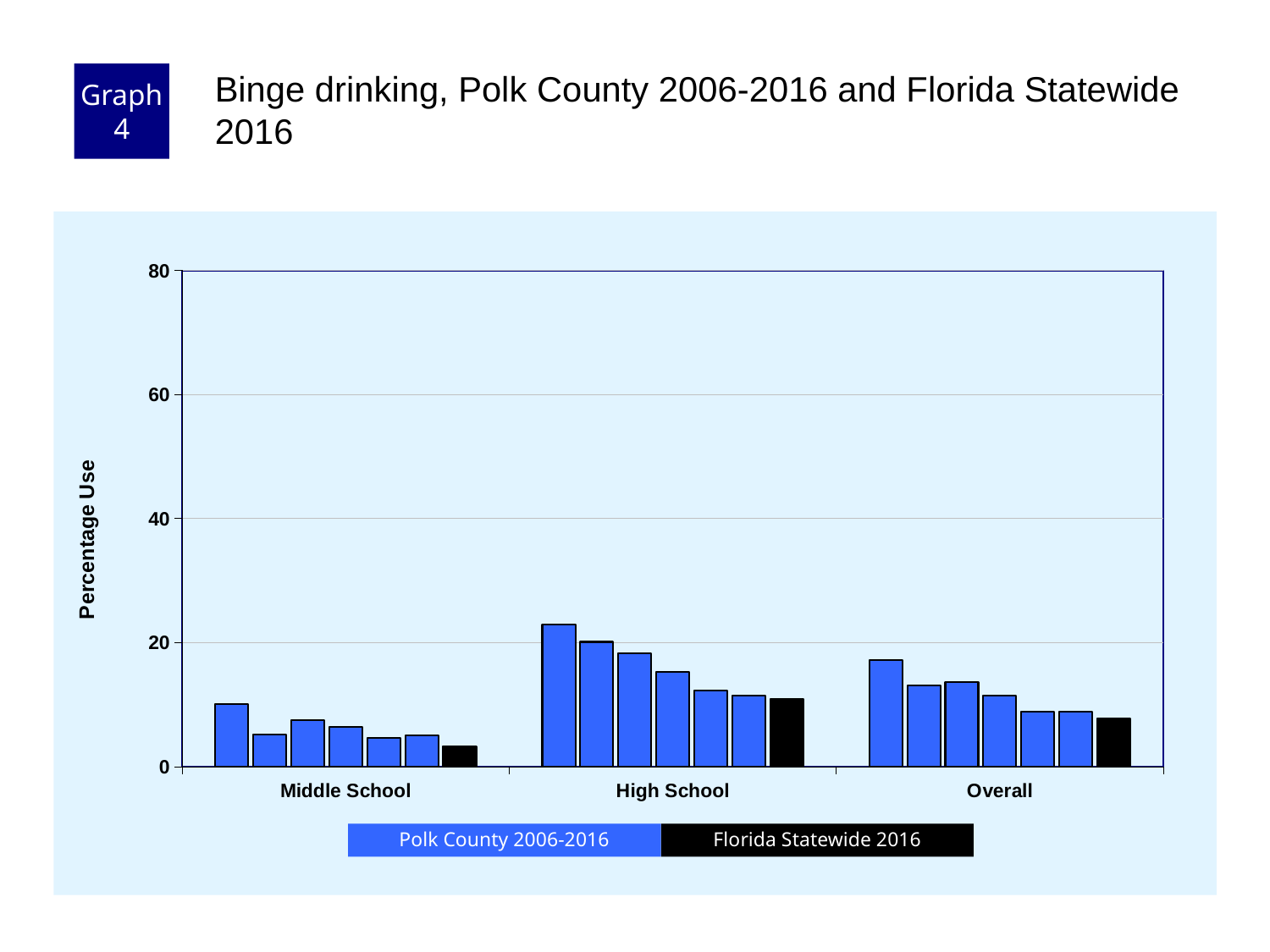
Is the tallest Polk County bar for High School greater or less than 20? greater How many categories are shown on the x axis? 3 What is the label on the y axis? Percentage Use Which category has the lowest bars overall? Middle School What colour are the Florida Statewide 2016 bars? black What kind of chart is shown on the slide? bar chart Which category has the tallest bar? High School Do the Polk County 2006-2016 bars for High School rise or fall from left to right? fall Which is larger, the Florida Statewide 2016 value for High School or for Middle School? High School How many series does the legend list? 2 Is the Florida Statewide 2016 value for Middle School greater or less than 20? less Is the tallest Polk County bar for Overall greater or less than 40? less